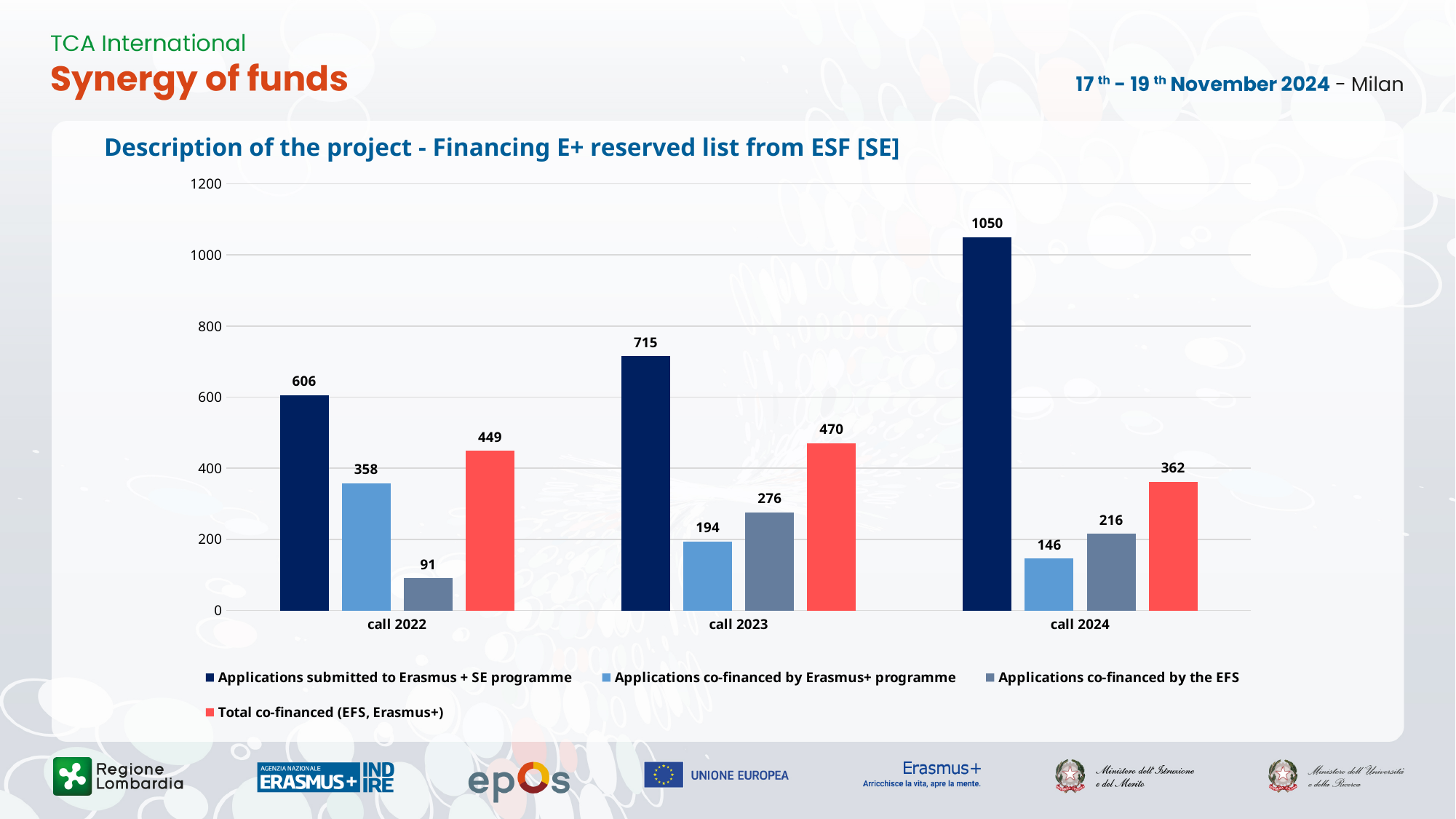
What is the value for Applications co-financed by the EFS in call 2022? 91 Is the value for Applications submitted to Erasmus + SE programme in call 2022 greater or less than 800? less Do the values for Applications submitted to Erasmus + SE programme rise or fall from call 2022 to call 2024? rise Which call has the lowest value for Applications co-financed by Erasmus+ programme? call 2024 How many series does the legend list? 4 What is the value for Applications co-financed by Erasmus+ programme in call 2024? 146 Which call has the highest number of Applications submitted to Erasmus + SE programme? call 2024 What kind of chart is shown on the slide? bar chart What is the difference between Applications submitted to Erasmus + SE programme in call 2024 and call 2023? 335 What is the value for Applications submitted to Erasmus + SE programme in call 2024? 1050 What is the Total co-financed (EFS, Erasmus+) value for call 2023? 470 Which is larger in call 2023: Applications co-financed by Erasmus+ programme or Applications co-financed by the EFS? Applications co-financed by the EFS